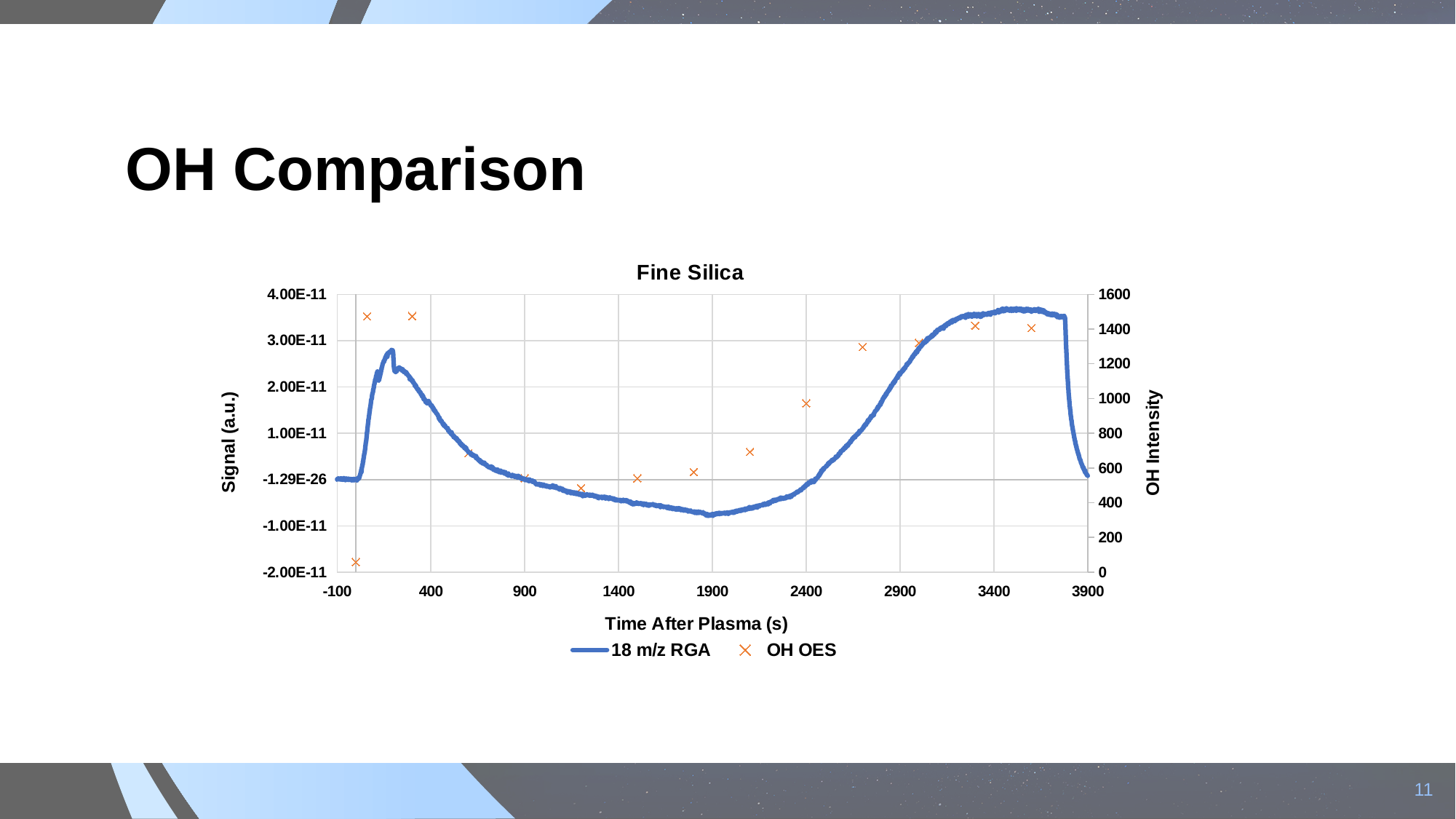
What are the two series named in the legend? 18 m/z RGA and OH OES Does the 18 m/z RGA signal rise or fall between 400 s and 1900 s? fall Which is larger, the OH OES value at about 2400 s or at about 900 s? 2400 s Is the OH OES value at about 900 s greater or less than 800? less Does the 18 m/z RGA signal rise or fall between 1900 s and 3400 s? rise What is the label of the x axis? Time After Plasma (s) Is the OH OES value at about 2400 s greater or less than 800? greater Is the OH OES value at about 1200 s greater or less than 600? less How many series does the legend list? 2 What is the title of the chart? Fine Silica